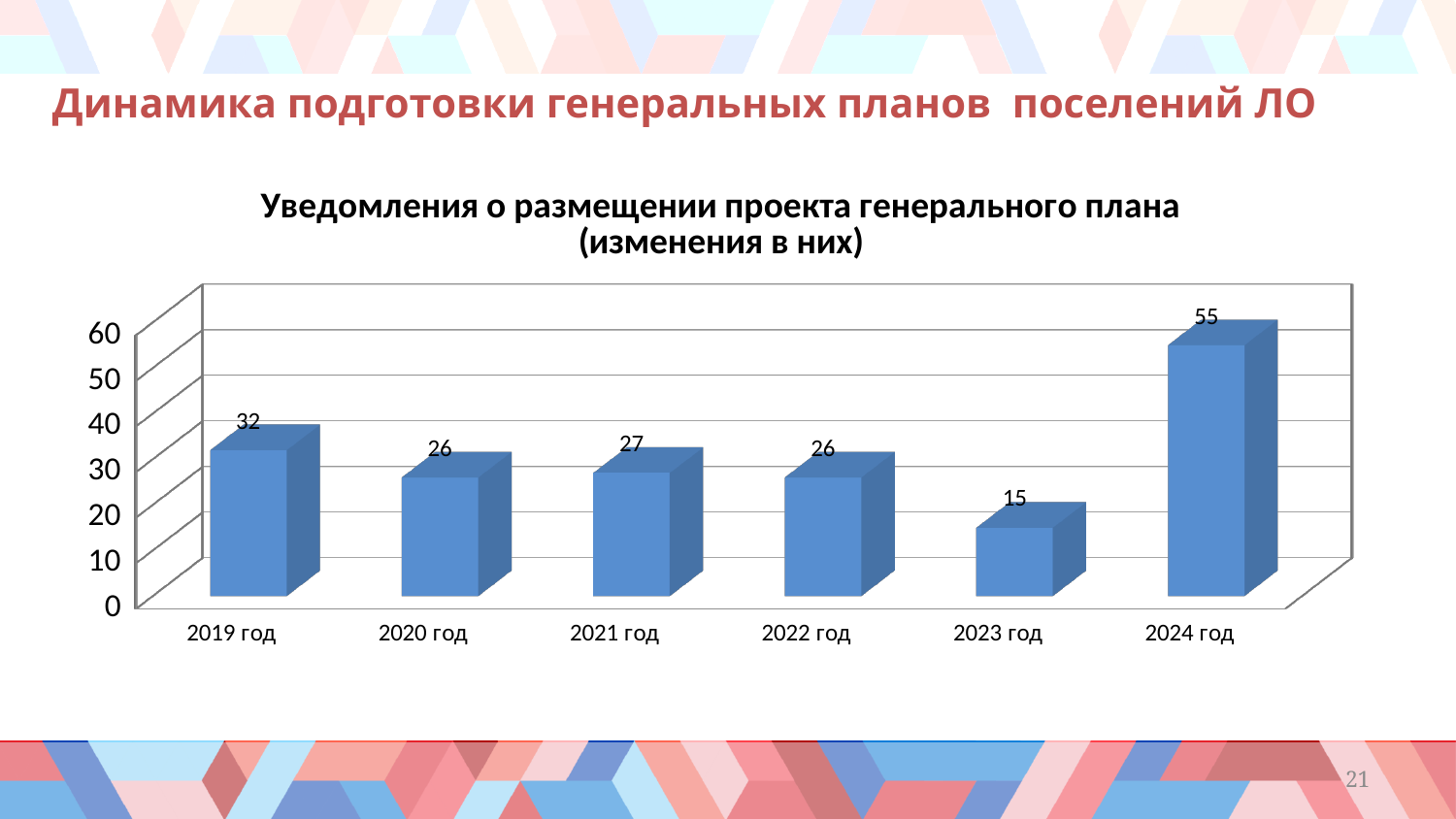
Which is larger, the value for 2019 год or the value for 2021 год? 2019 год What is the value for 2024 год? 55 What is the value for 2019 год? 32 What is the difference between the values for 2024 год and 2023 год? 40 What is the value for 2023 год? 15 What is the difference between the values for 2019 год and 2020 год? 6 What kind of chart is shown on the slide? bar chart Is the value for 2024 год greater or less than 50? greater What is the title of the chart? Уведомления о размещении проекта генерального плана (изменения в них) Which year has the lowest value? 2023 год Which year has the highest value? 2024 год How many years are shown on the x axis? 6